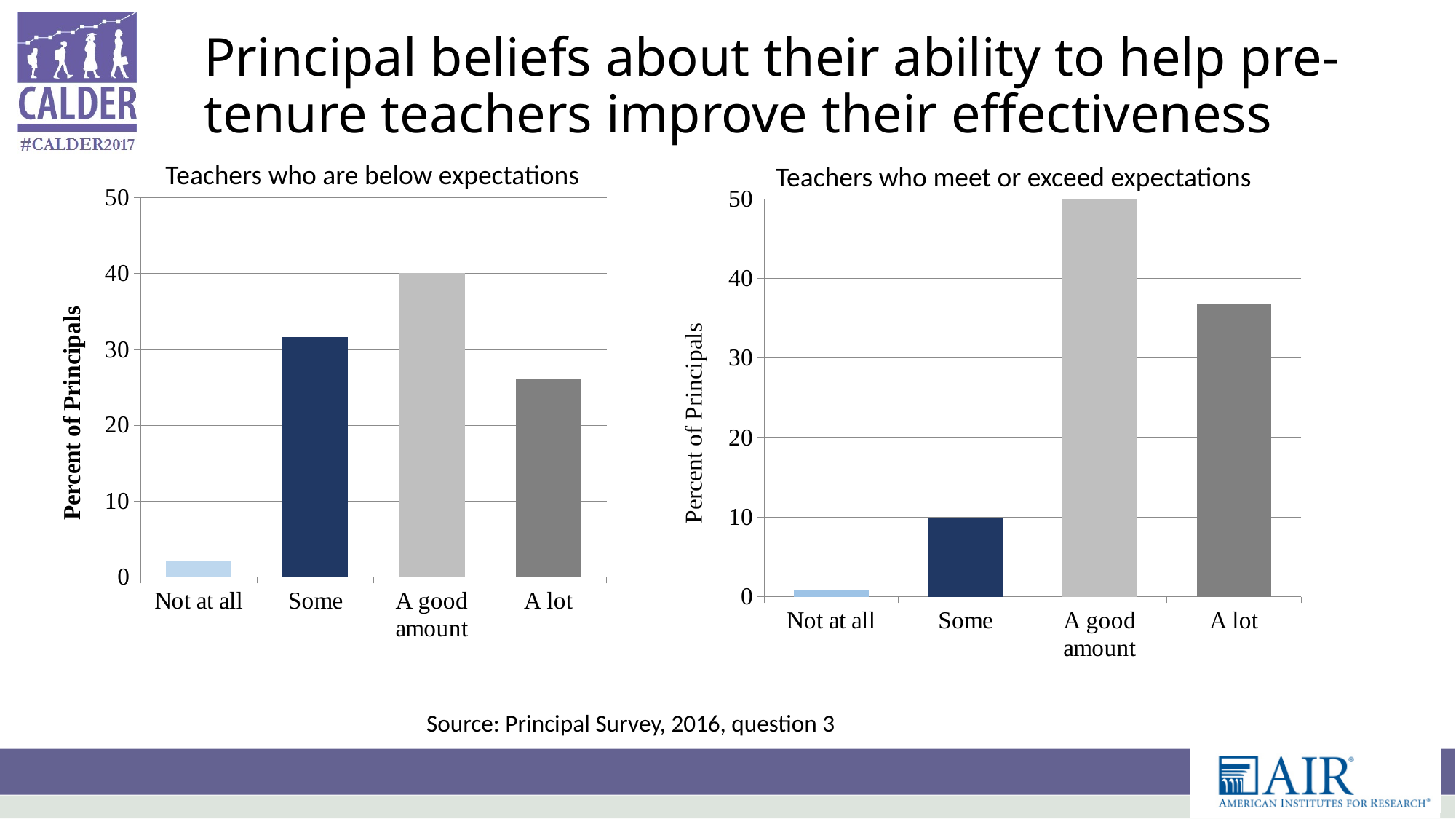
In the 'Teachers who are below expectations' chart, what is the percent of principals for 'A good amount'? 40 In the 'Teachers who are below expectations' chart, is the value for 'A lot' greater or less than 30? less In the 'Teachers who are below expectations' chart, which category has the highest percent of principals? A good amount How many categories are shown on the x axis of the 'Teachers who meet or exceed expectations' chart? 4 In the 'Teachers who meet or exceed expectations' chart, which category has the highest percent of principals? A good amount In the 'Teachers who are below expectations' chart, is the value for 'Some' greater or less than 30? greater In the 'Teachers who are below expectations' chart, which category has the lowest percent of principals? Not at all What kind of chart is the 'Teachers who are below expectations' chart? bar chart In the 'Teachers who meet or exceed expectations' chart, is the value for 'A lot' greater or less than 30? greater In the 'Teachers who meet or exceed expectations' chart, which is larger, the value for 'Some' or the value for 'A lot'? A lot In the 'Teachers who meet or exceed expectations' chart, what is the percent of principals for 'Some'? 10